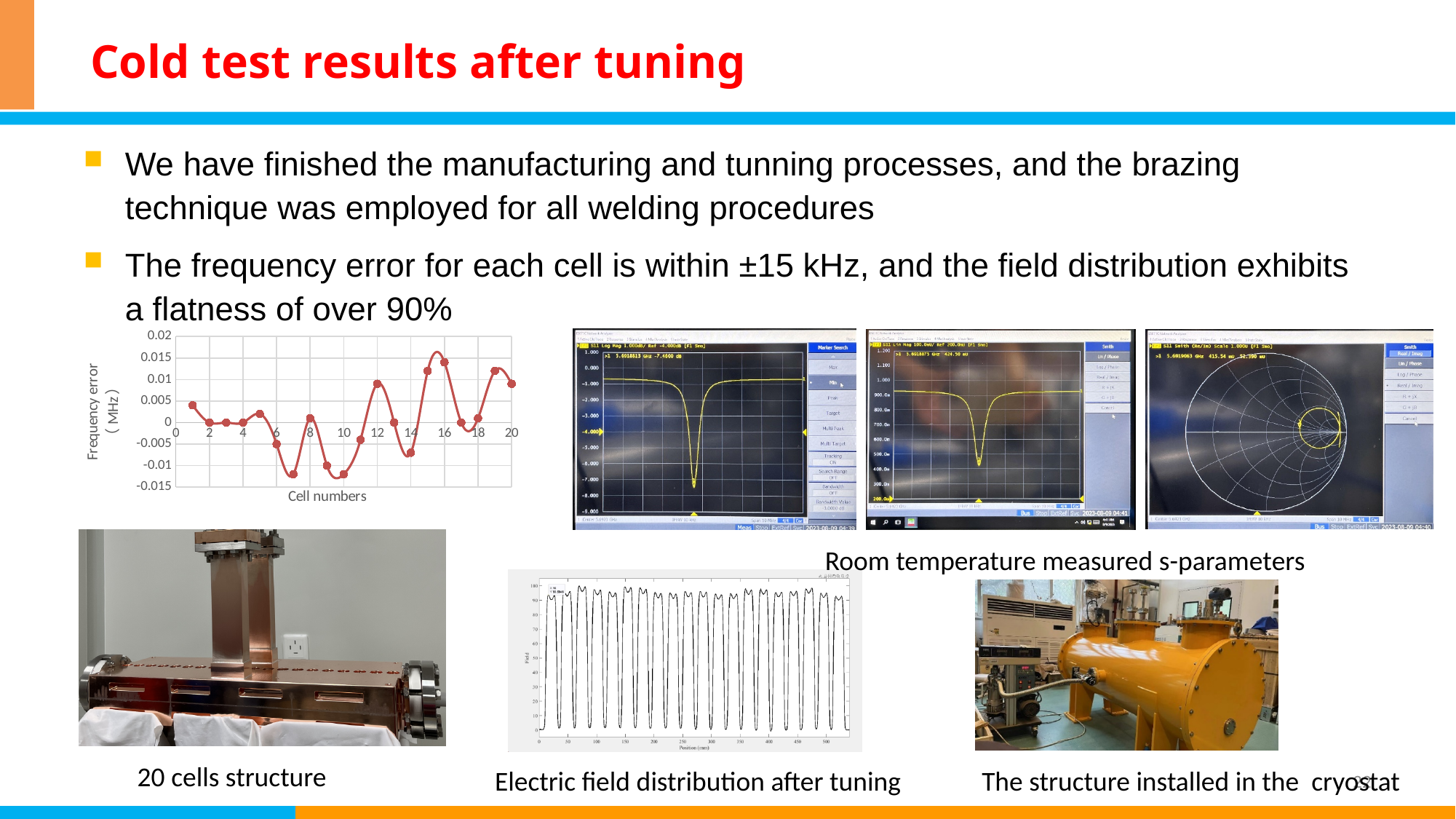
In the frequency error chart, which is larger, the value for cell 12 or the value for cell 14? cell 12 In the frequency error chart, is the value for cell 16 greater or less than 0.01? greater In the frequency error chart, is the value for cell 7 greater or less than -0.01? less In the frequency error chart, is the value for cell 12 greater or less than 0.005? greater In the frequency error chart, how many cell data points are plotted? 20 What is the x-axis label of the frequency error chart? Cell numbers What kind of chart is the frequency error chart on the left of the slide? line chart What is the y-axis label of the frequency error chart? Frequency error (MHz) In the frequency error chart, which is larger, the value for cell 7 or the value for cell 8? cell 8